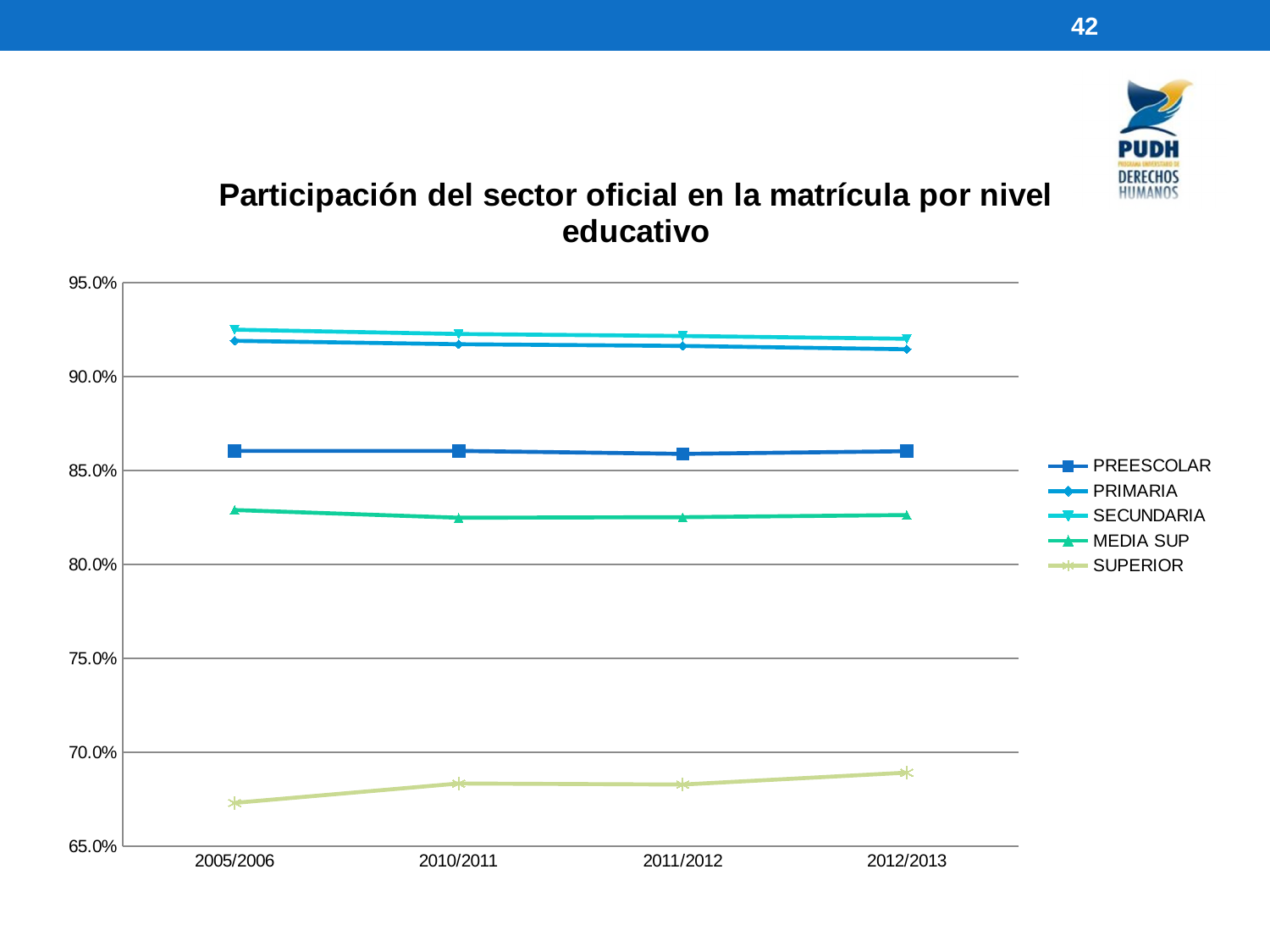
Which series has the highest value in 2005/2006? SECUNDARIA Is the value for SUPERIOR in 2005/2006 greater or less than 70.0%? less In 2011/2012, which is larger: PREESCOLAR or MEDIA SUP? PREESCOLAR What is the title of the chart? Participación del sector oficial en la matrícula por nivel educativo Is the value for PREESCOLAR in 2012/2013 greater or less than 85.0%? greater How many series does the legend list? 5 How many school-year categories are shown on the x axis? 4 What kind of chart is shown on the slide? line chart Does the SUPERIOR series rise or fall from 2005/2006 to 2012/2013? rise Is the value for MEDIA SUP in 2010/2011 greater or less than 85.0%? less Does the PRIMARIA series rise or fall from 2005/2006 to 2012/2013? fall Which series has the lowest values across all years? SUPERIOR